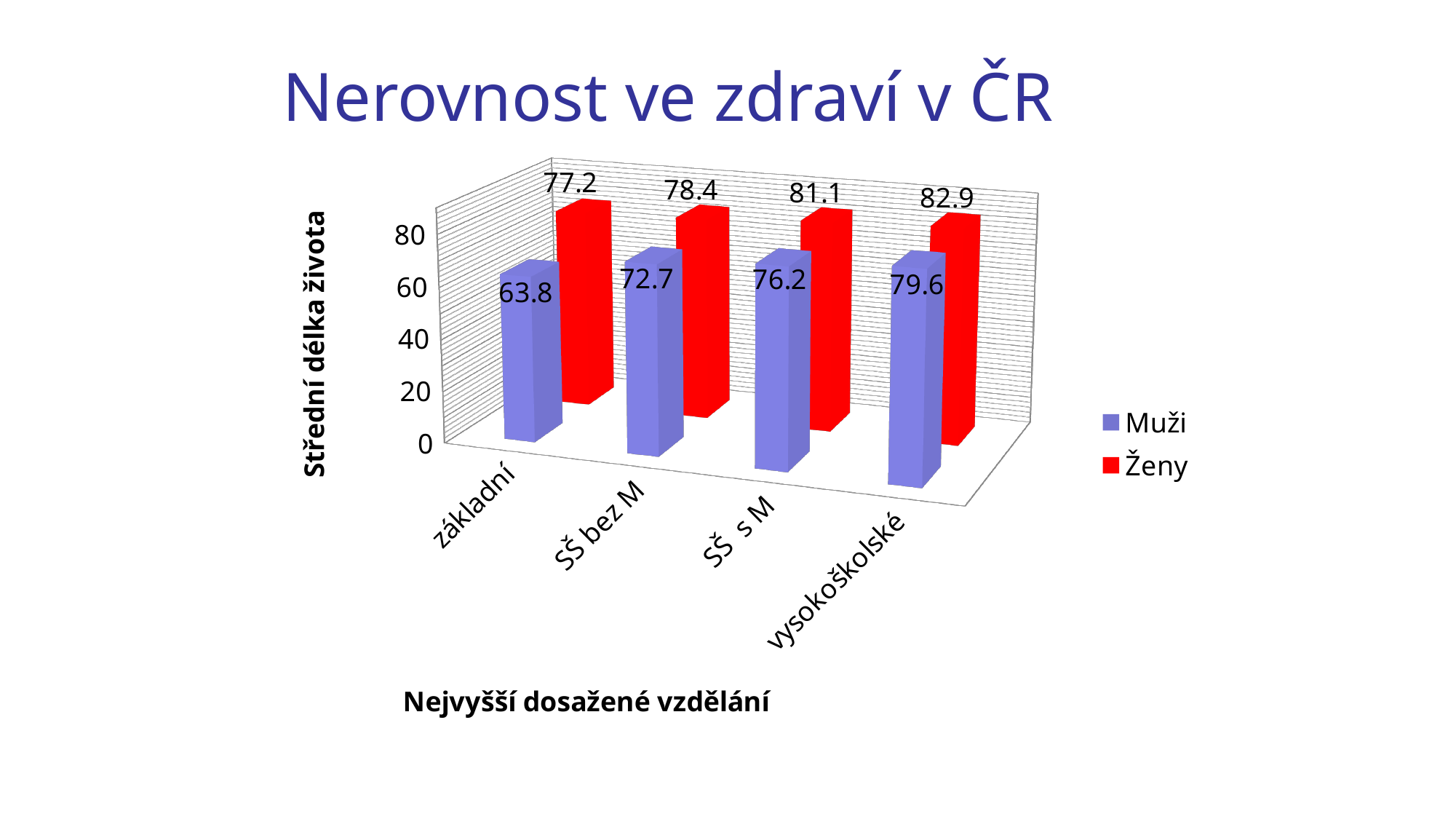
Do the Ženy values rise or fall from základní to vysokoškolské? rise What is the value for Muži in the základní category? 63.8 Which is larger: the Muži value for vysokoškolské or the Ženy value for základní? Muži value for vysokoškolské What is the value for Muži in the SŠ s M category? 76.2 Which category has the highest value for Muži? vysokoškolské Which category has the lowest value for Ženy? základní What is the difference between the Ženy and Muži values in the základní category? 13.4 How many series does the legend list? 2 What is the difference between the Muži values for vysokoškolské and základní? 15.8 What is the value for Ženy in the SŠ bez M category? 78.4 How many categories are shown on the x axis? 4 What is the value for Ženy in the vysokoškolské category? 82.9